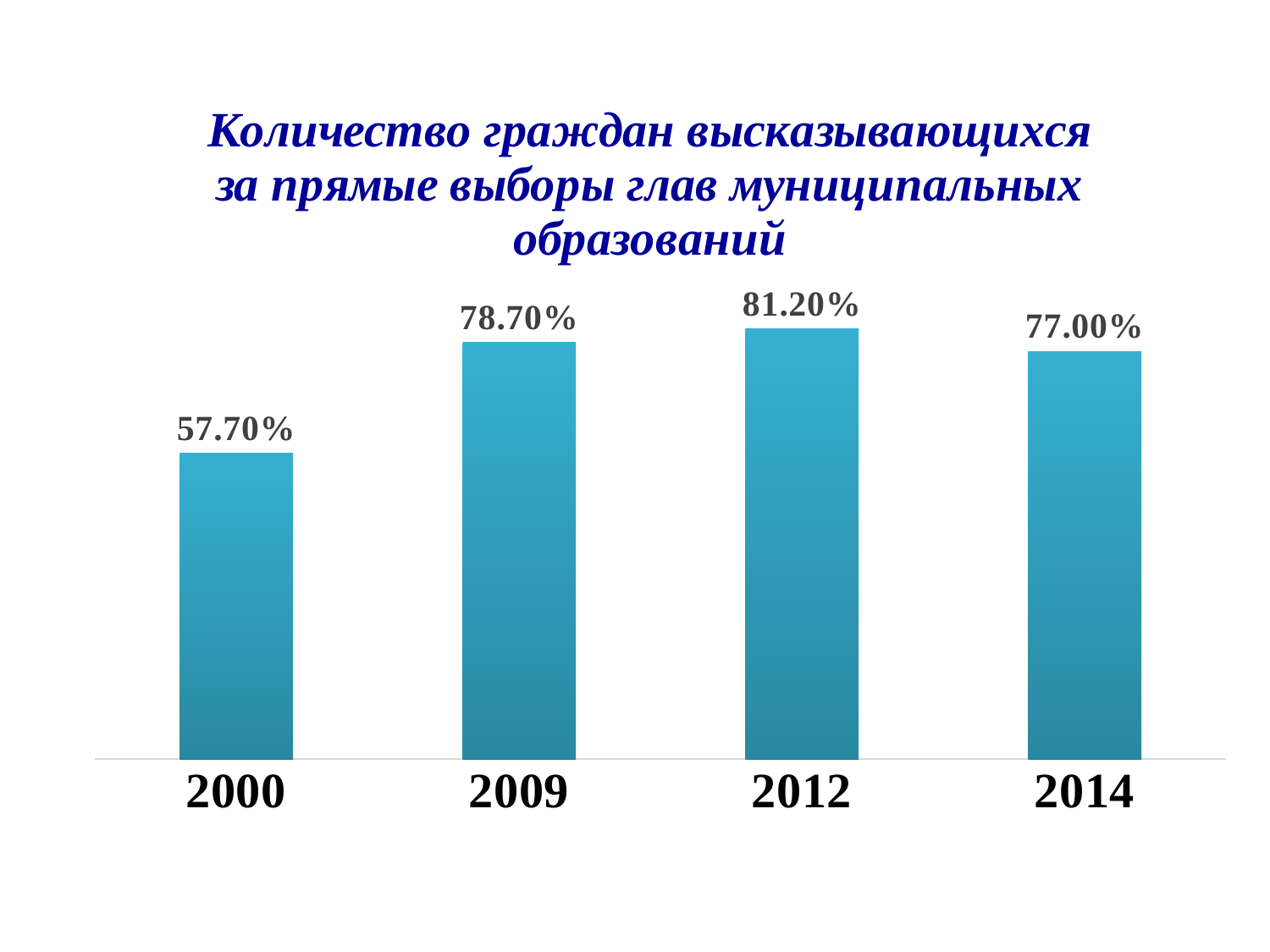
Which year has the lowest value? 2000 How many years are shown on the x axis? 4 What is the difference between the values for 2009 and 2014? 1.70% Which year has the highest value? 2012 What is the difference between the values for 2012 and 2000? 23.50% What kind of chart is this? Bar chart What is the value for 2009? 78.70% What is the value for 2012? 81.20% Which is larger, the value for 2009 or the value for 2014? 2009 Does the value rise or fall from 2012 to 2014? Fall What is the value for 2014? 77.00% What is the value for 2000? 57.70%